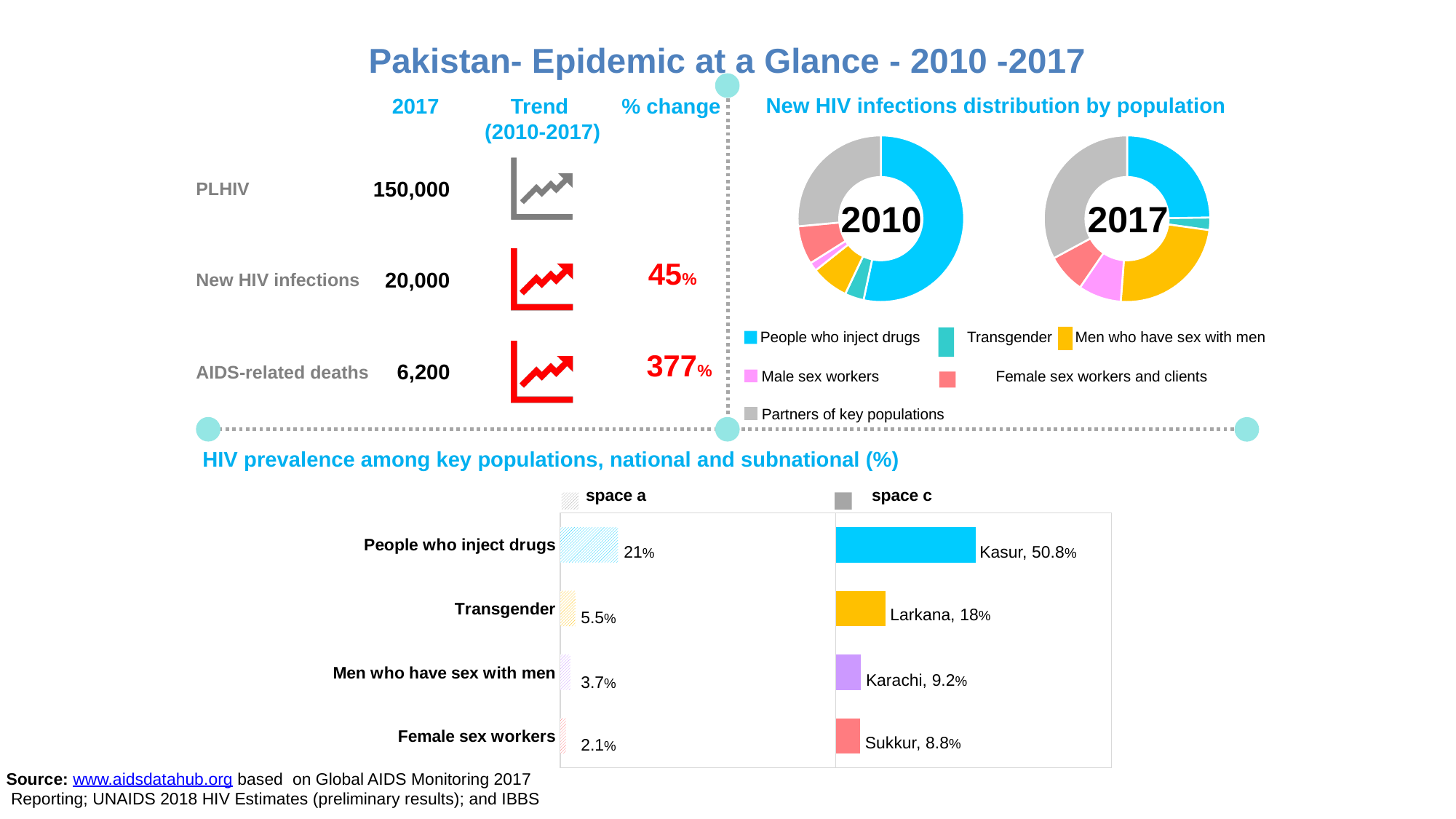
In the HIV prevalence bar chart, how much higher is the Kasur prevalence among people who inject drugs than the national value for that population? 29.8 percentage points In the HIV prevalence bar chart, what is the subnational HIV prevalence value shown for female sex workers? Sukkur, 8.8% What type of chart is used for HIV prevalence among key populations? Bar chart How many populations does the legend of the new HIV infections distribution donut charts list? 6 In the 2010 donut chart of new HIV infections distribution by population, which population has the largest share? People who inject drugs In the HIV prevalence bar chart, what is the national HIV prevalence among people who inject drugs? 21% In the HIV prevalence bar chart, what is the national HIV prevalence among transgender people? 5.5% In the HIV prevalence bar chart, which key population has the lowest national HIV prevalence? Female sex workers In the HIV prevalence bar chart, what is the subnational HIV prevalence value shown for men who have sex with men? Karachi, 9.2% How many key populations are shown in the HIV prevalence bar chart? 4 In the HIV prevalence bar chart, which key population has the highest national HIV prevalence? People who inject drugs In the HIV prevalence bar chart, which is larger: the Larkana value for transgender people or the Karachi value for men who have sex with men? Larkana, 18%